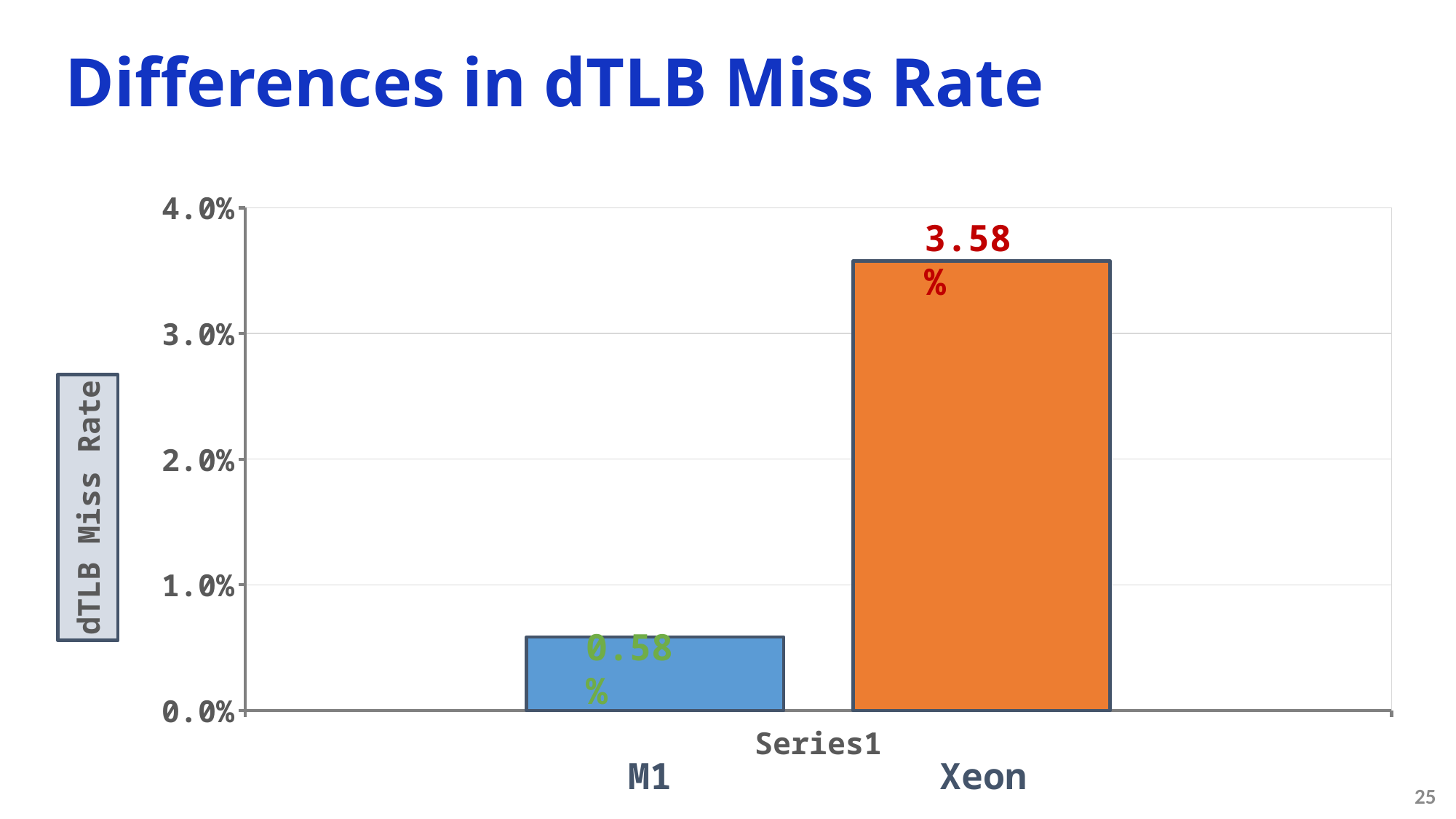
What is the label on the vertical axis of the chart? dTLB Miss Rate Is the dTLB miss rate for Xeon greater or less than 3.0%? greater Which processor has the higher dTLB miss rate? Xeon What is the difference between the Xeon and M1 dTLB miss rates? 3.00% What kind of chart is shown on the slide? bar chart What is the title of the slide? Differences in dTLB Miss Rate Is the dTLB miss rate for M1 greater or less than 1.0%? less What is the dTLB miss rate for Xeon? 3.58% Is the dTLB miss rate for M1 larger or smaller than that for Xeon? smaller What is the dTLB miss rate for M1? 0.58% How many bars are plotted in the chart? 2 Which processor has the lower dTLB miss rate? M1